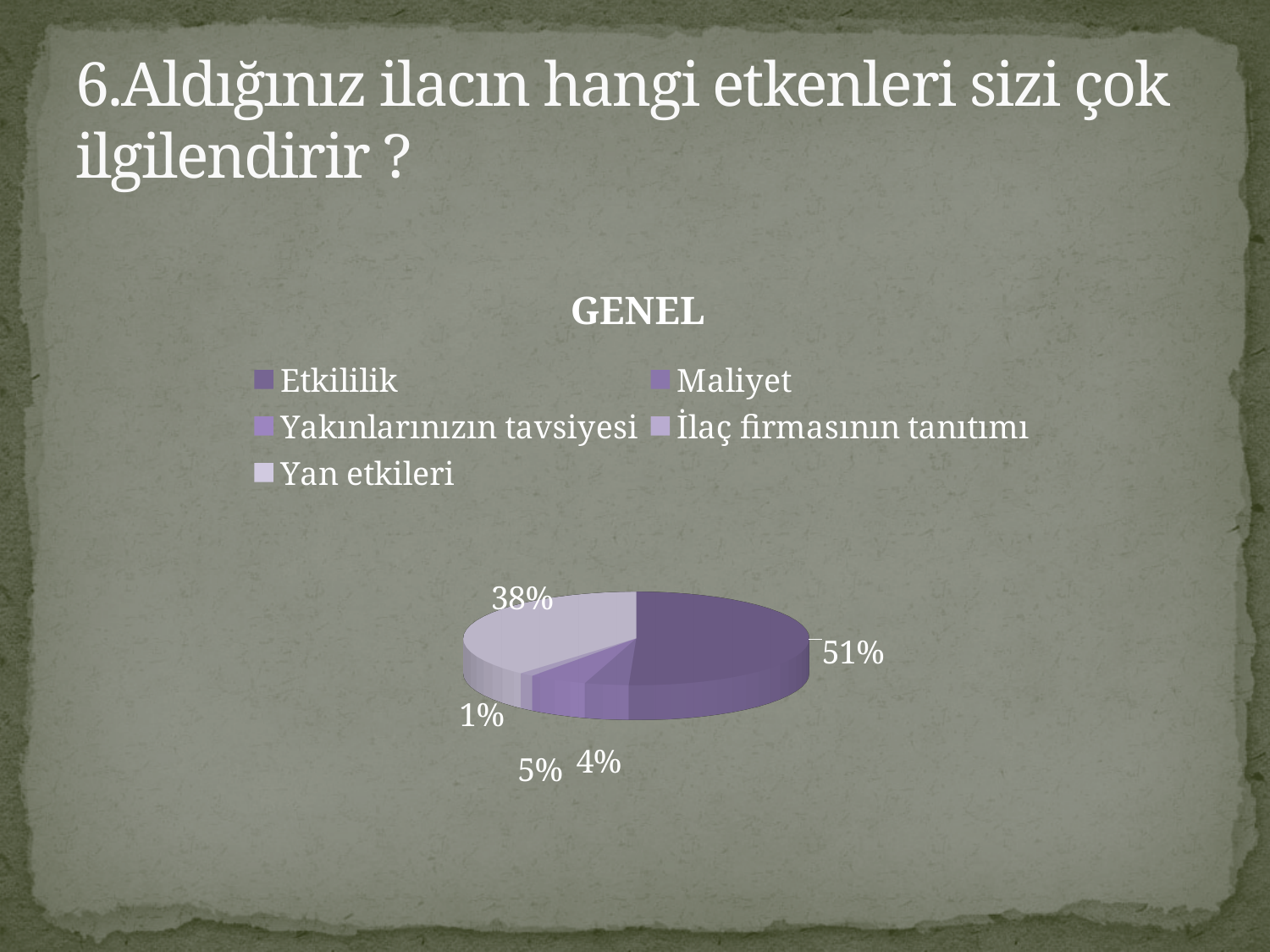
What is the title of the chart? GENEL What is the difference in percentage points between Etkililik and Yan etkileri? 13 How many categories does the legend of the chart list? 5 What type of chart is shown on the slide? Pie chart What share of the pie does Yan etkileri have? 38% What share of the pie does İlaç firmasının tanıtımı have? 1% What share of the pie does Yakınlarınızın tavsiyesi have? 5% Which category has the smallest slice of the pie? İlaç firmasının tanıtımı Which is larger, the slice for Maliyet or the slice for Yakınlarınızın tavsiyesi? Yakınlarınızın tavsiyesi Which category has the largest slice of the pie? Etkililik What share of the pie does Etkililik have? 51% What share of the pie does Maliyet have? 4%